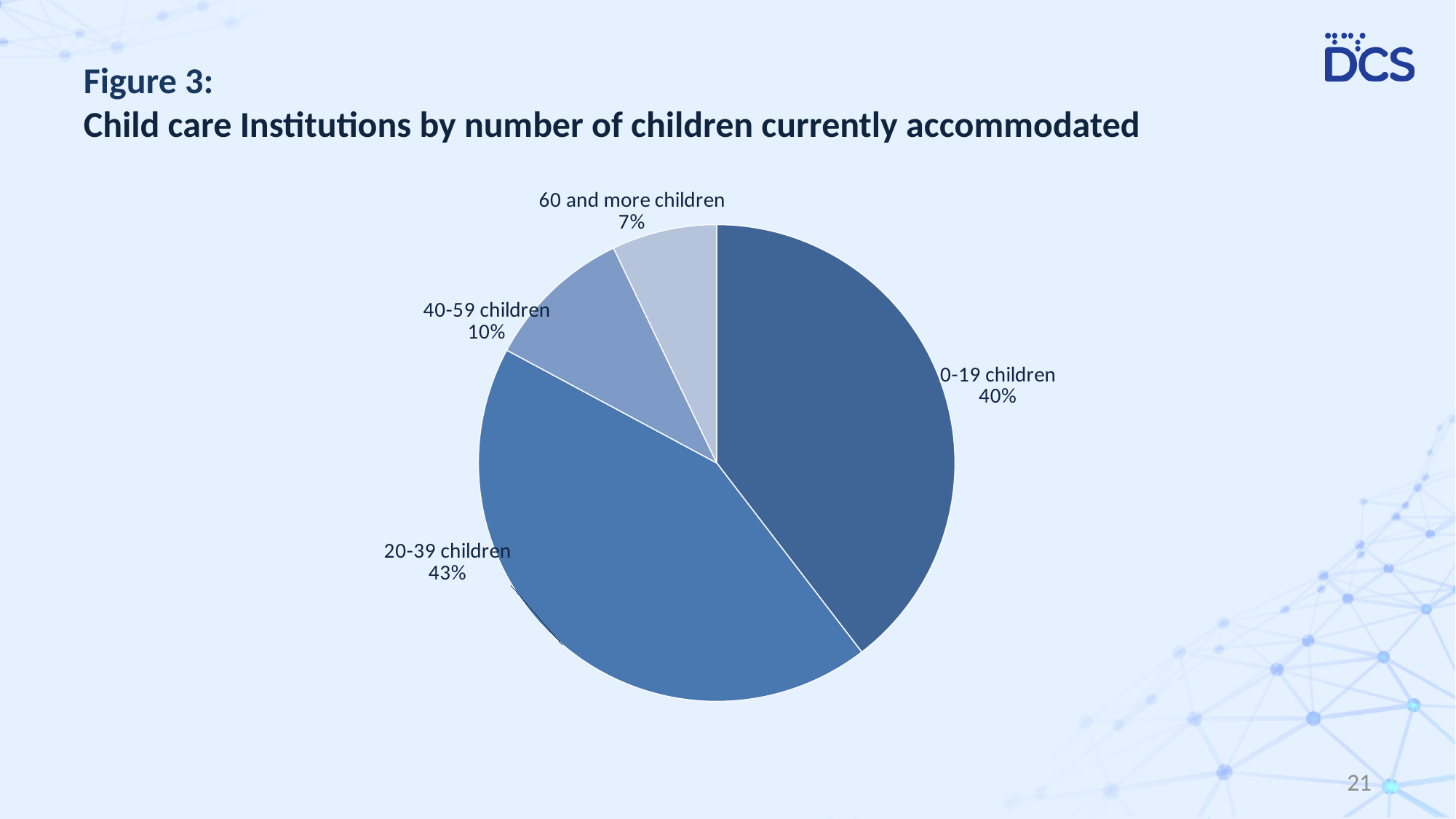
What share of child care institutions accommodate 20-39 children? 43% Which category has the smallest share of the pie? 60 and more children What share of child care institutions accommodate 0-19 children? 40% Which category has the largest share of the pie? 20-39 children What is the difference in percentage points between the 40-59 children slice and the 60 and more children slice? 3 What kind of chart is shown on the slide? Pie chart How many categories are shown in the pie chart? 4 What is the difference in percentage points between the 20-39 children slice and the 0-19 children slice? 3 What share of child care institutions accommodate 40-59 children? 10% What share of child care institutions accommodate 60 and more children? 7% Which is larger: the share for 40-59 children or the share for 60 and more children? 40-59 children What is the title of the chart on the slide? Child care Institutions by number of children currently accommodated